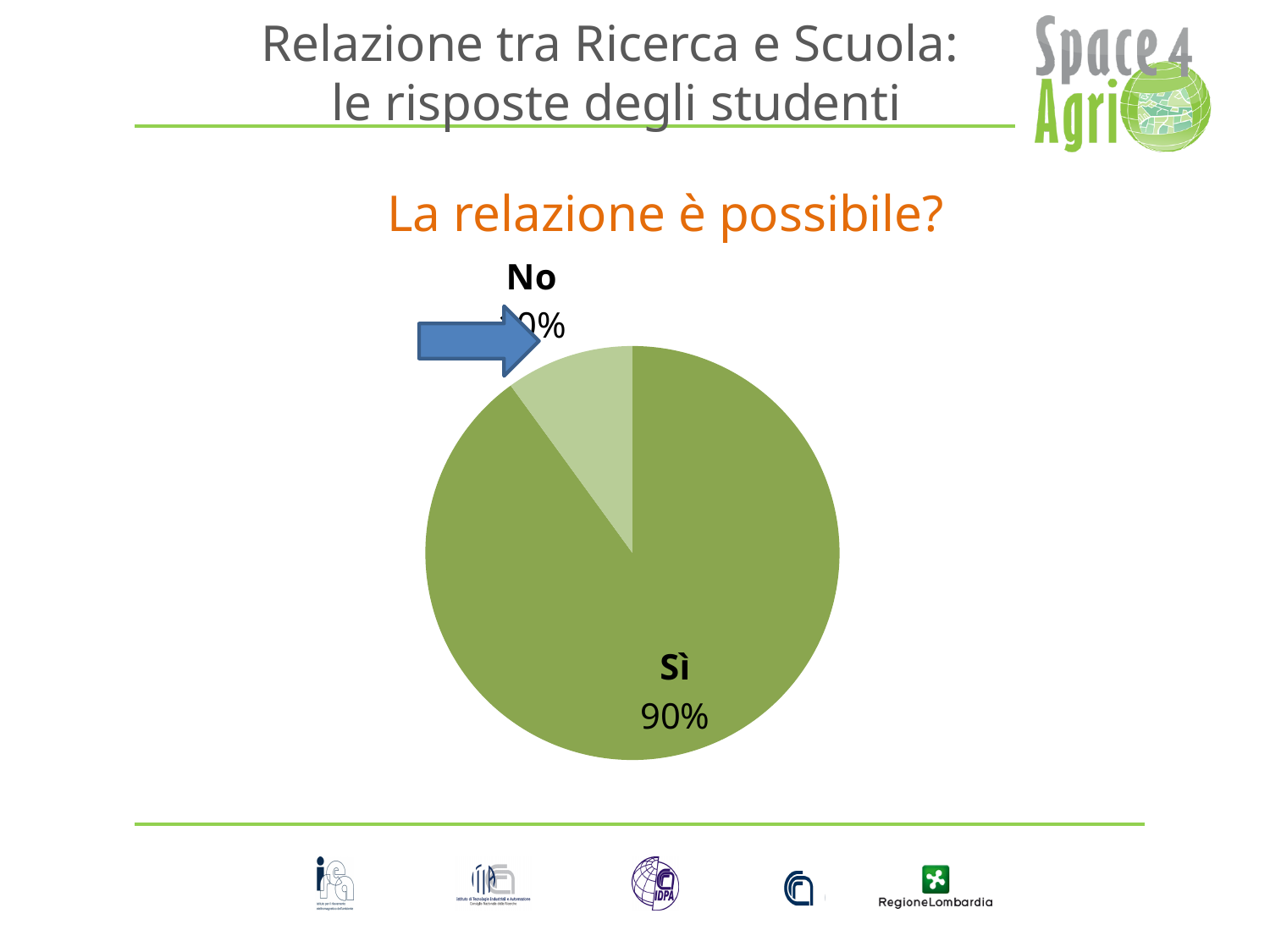
Which response has the largest slice of the pie chart? Sì Which response has the smallest slice of the pie chart? No What kind of chart is shown on the slide? Pie chart Which slice of the pie chart is shown in the lighter green colour? No What percentage of students answered "Sì" in the pie chart? 90% Which slice is larger in the pie chart, "Sì" or "No"? Sì What is the title of the chart on the slide? La relazione è possibile? What share of the pie does the "Sì" slice represent? 90% How many slices does the pie chart have? 2